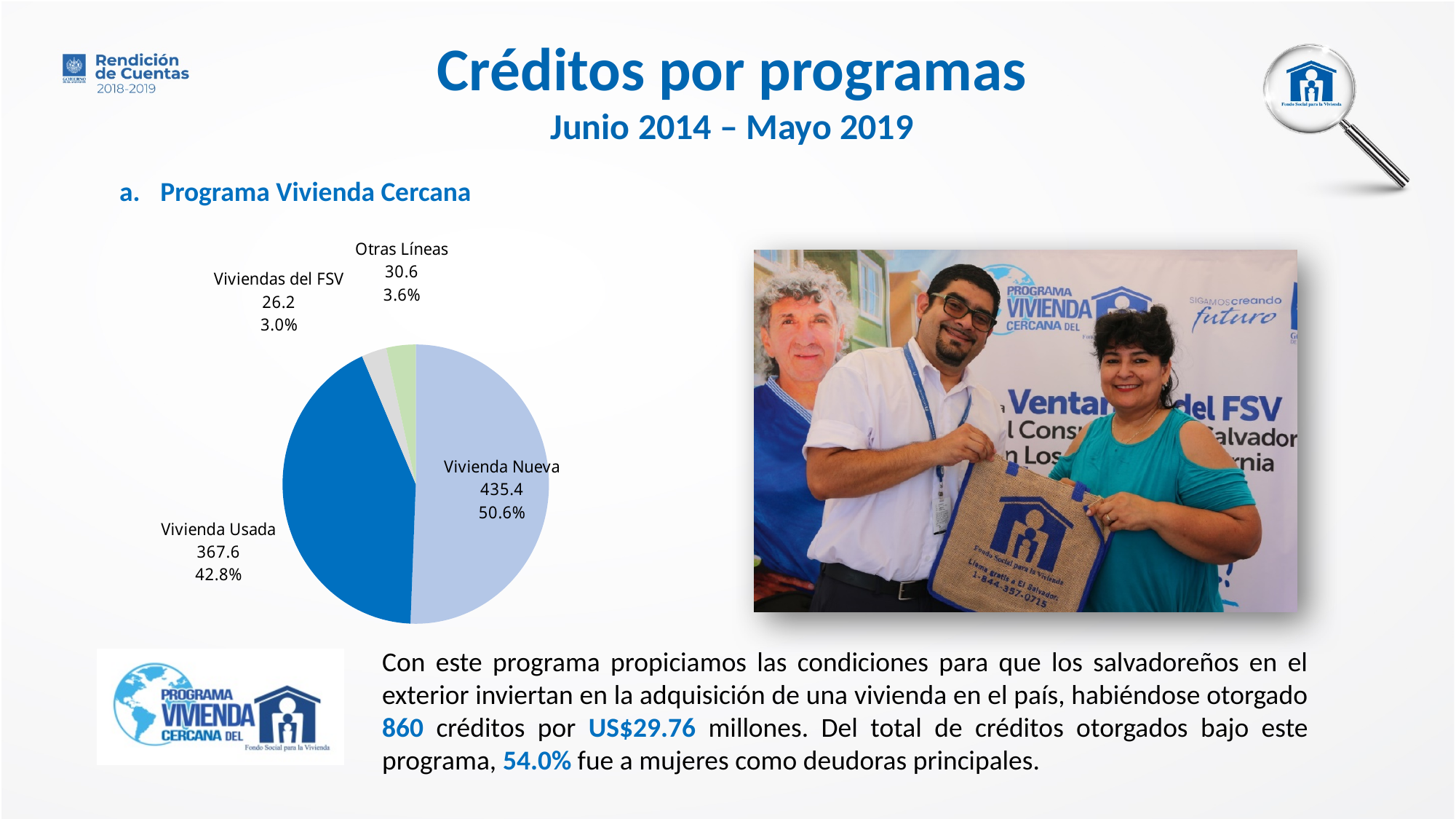
What is the value shown for Viviendas del FSV in the pie chart? 26.2 What share of the pie does Vivienda Nueva represent? 50.6% What share of the pie does Vivienda Usada represent? 42.8% Which is larger, the value for Otras Líneas or the value for Viviendas del FSV? Otras Líneas What kind of chart is shown on the slide? Pie chart What is the value shown for Vivienda Usada in the pie chart? 367.6 How many slices does the pie chart have? 4 What is the difference between the values for Vivienda Nueva and Vivienda Usada? 67.8 Which category has the smallest slice in the pie chart? Viviendas del FSV What is the value shown for Vivienda Nueva in the pie chart? 435.4 Which category has the largest slice in the pie chart? Vivienda Nueva What is the value shown for Otras Líneas in the pie chart? 30.6